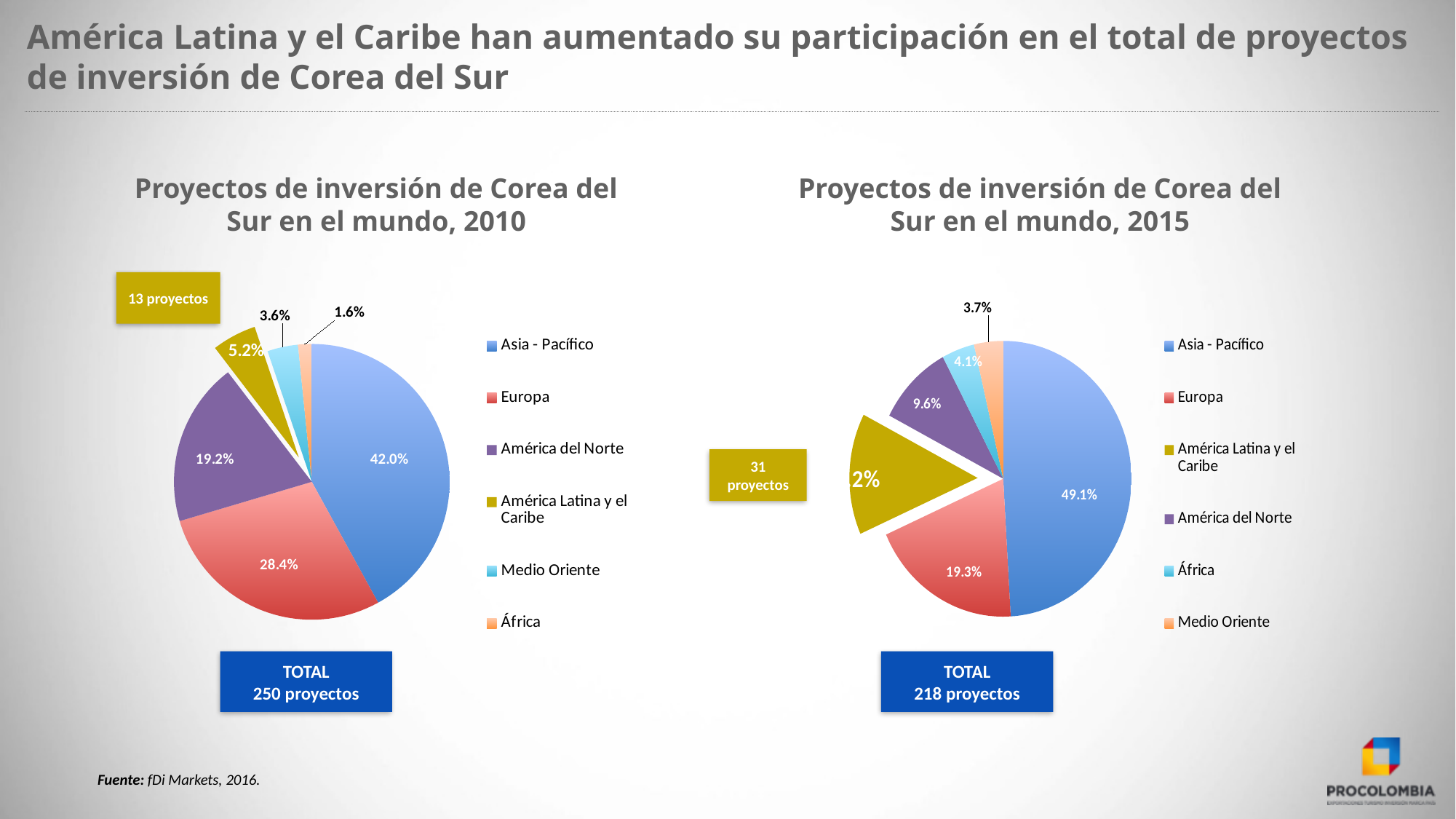
In the 2015 chart, what share of projects does América del Norte have? 9.6% In the 2015 chart, what share of projects does Europa have? 19.3% In the 2010 chart, which region has the smallest share? África In the 2010 chart, what is the difference between the shares of Europa and América del Norte? 9.2% In the 2010 chart, what share of projects does América Latina y el Caribe have? 5.2% In the 2010 chart, what share of projects does Europa have? 28.4% In the 2015 chart, which region has the largest share? Asia - Pacífico In the 2015 chart, what share of projects does Asia - Pacífico have? 49.1% How many regions does the legend of the 2015 chart list? 6 In the 2015 chart, which is larger: the share of Europa or the share of América del Norte? Europa What type of chart is used for 'Proyectos de inversión de Corea del Sur en el mundo, 2010'? Pie chart In the 2010 chart, what share of projects does Asia - Pacífico have? 42.0%